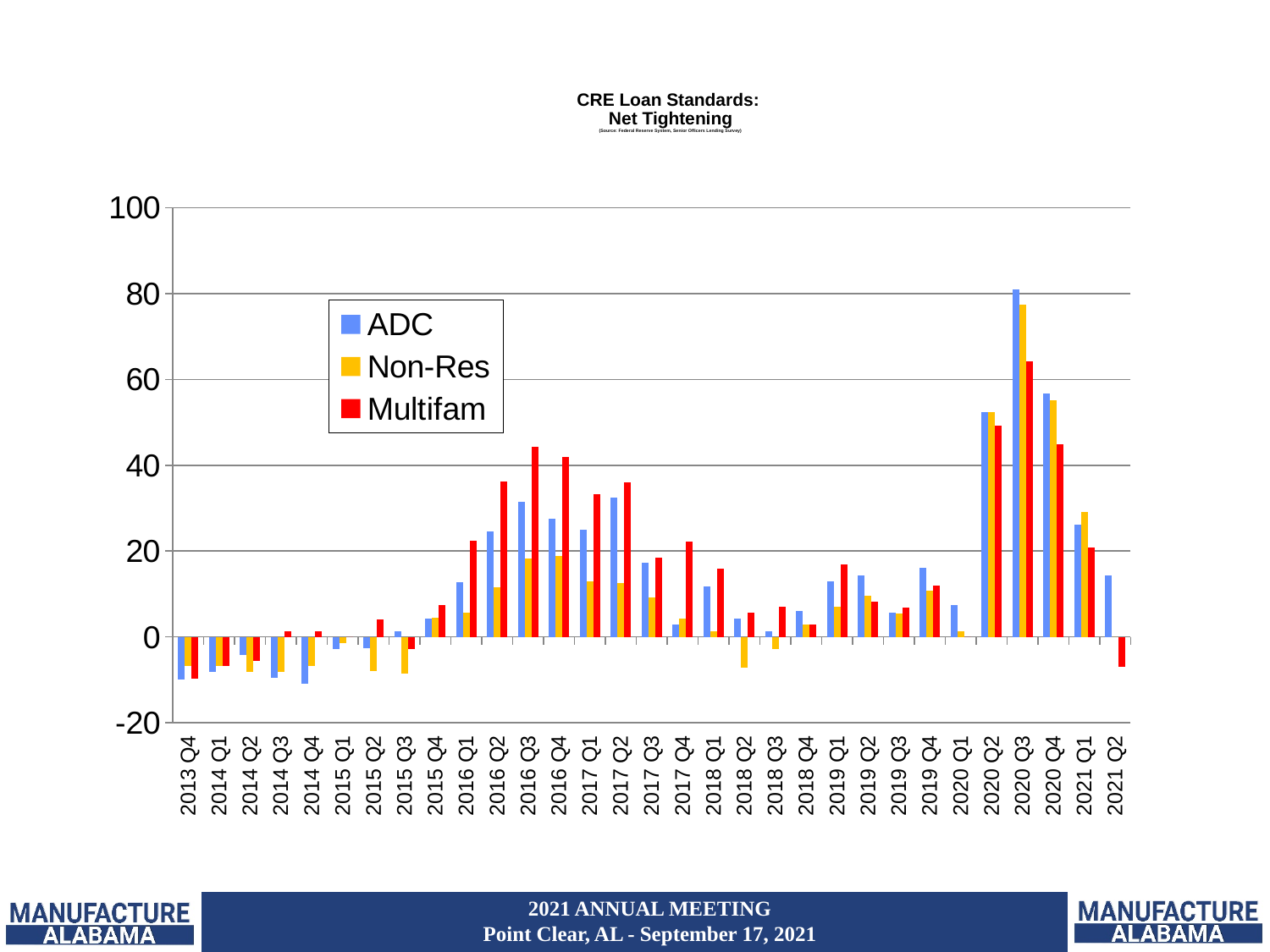
What kind of chart is shown on the slide? bar chart Which quarter has the highest Multifam value? 2020 Q3 How many quarters are shown on the x axis? 31 Is the ADC value for 2020 Q3 greater or less than 60? greater Is the Non-Res value for 2020 Q3 greater or less than 60? greater How many series does the legend list? 3 Which quarter has the highest ADC value? 2020 Q3 Which colour represents the Multifam series? red In 2020 Q3, which is larger, the ADC value or the Multifam value? ADC Is the ADC value for 2021 Q2 greater or less than 20? less In 2016 Q3, which is larger, the Multifam value or the Non-Res value? Multifam